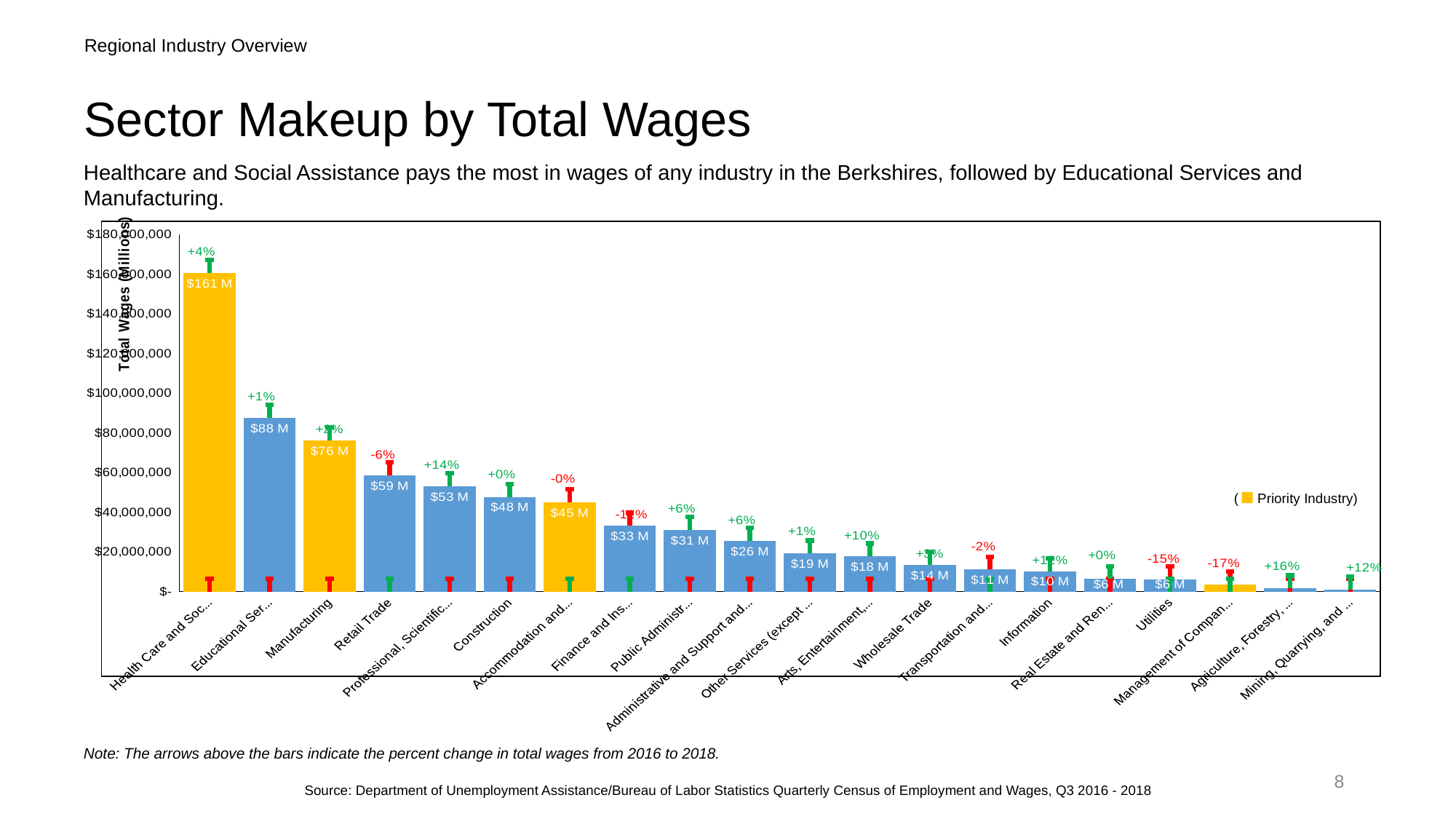
What is the difference in total wages between Manufacturing and Retail Trade? $17 M How many sectors are shown on the chart? 20 Is the total wages value for Educational Services greater or less than $80,000,000? greater What is the total wages value shown for Retail Trade? $59 M What percent change in total wages is shown above the Retail Trade bar? -6% What kind of chart is shown on the slide? bar chart What is the total wages value shown for Manufacturing? $76 M What is the total wages value shown for Construction? $48 M Which sector has the lowest total wages? Mining, Quarrying, and ... Which sector has the highest total wages? Health Care and Social Assistance Which has higher total wages, Construction or Wholesale Trade? Construction Do the total wages values rise or fall moving from left to right along the x axis? fall